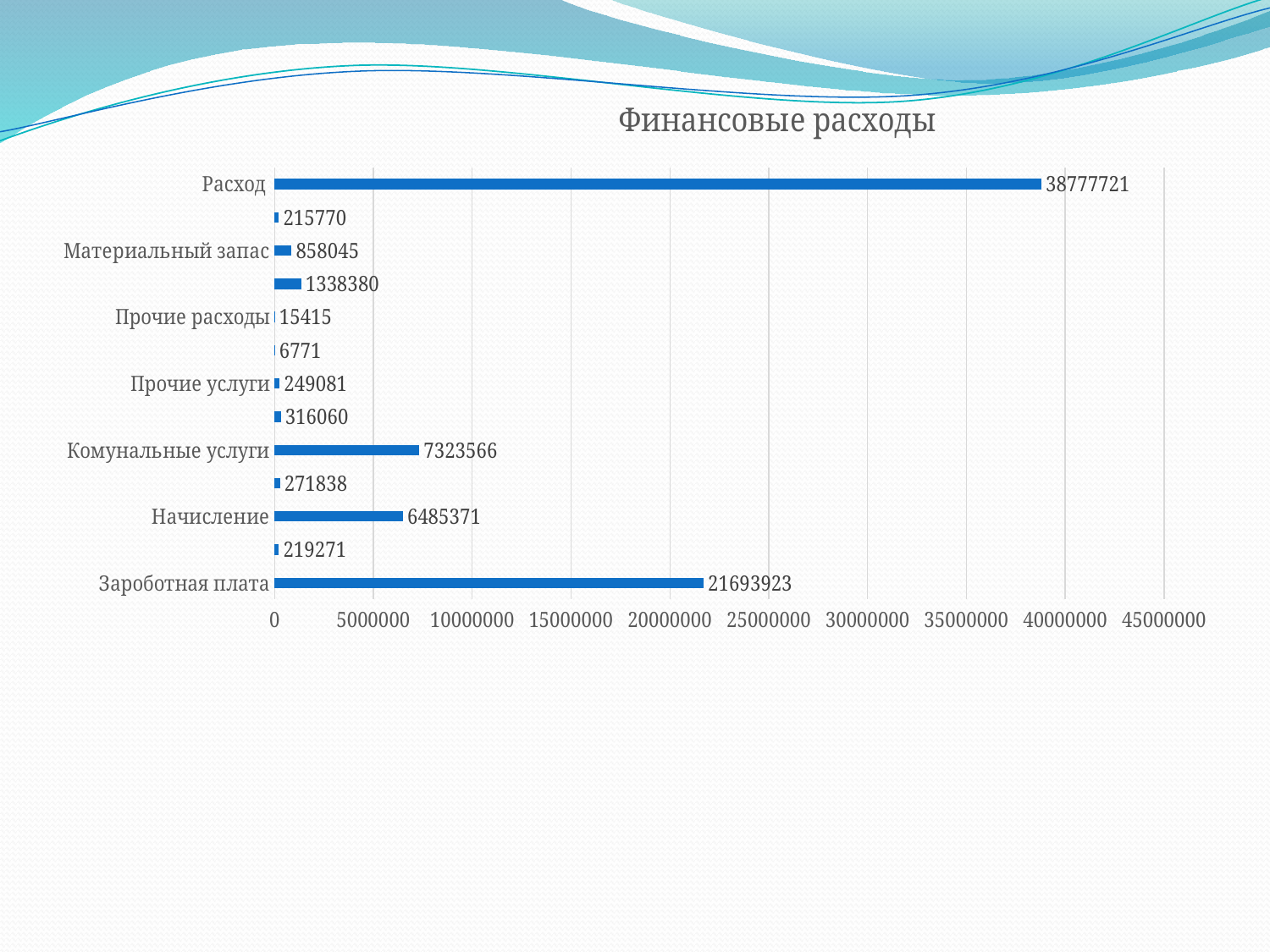
What is the value for Комунальные услуги? 7323566 What is the smallest value labelled on the chart? 6771 What is the difference between the values for Расход and Заработная плата? 17083798 What is the value for Расход? 38777721 What is the value for Прочие расходы? 15415 What is the title of the chart? Финансовые расходы What is the value for Материальный запас? 858045 What is the value for Заработная плата? 21693923 What is the value for Начисление? 6485371 Which is larger, the value for Комунальные услуги or the value for Начисление? Комунальные услуги Which category has the highest value? Расход What type of chart is shown on the slide? Bar chart